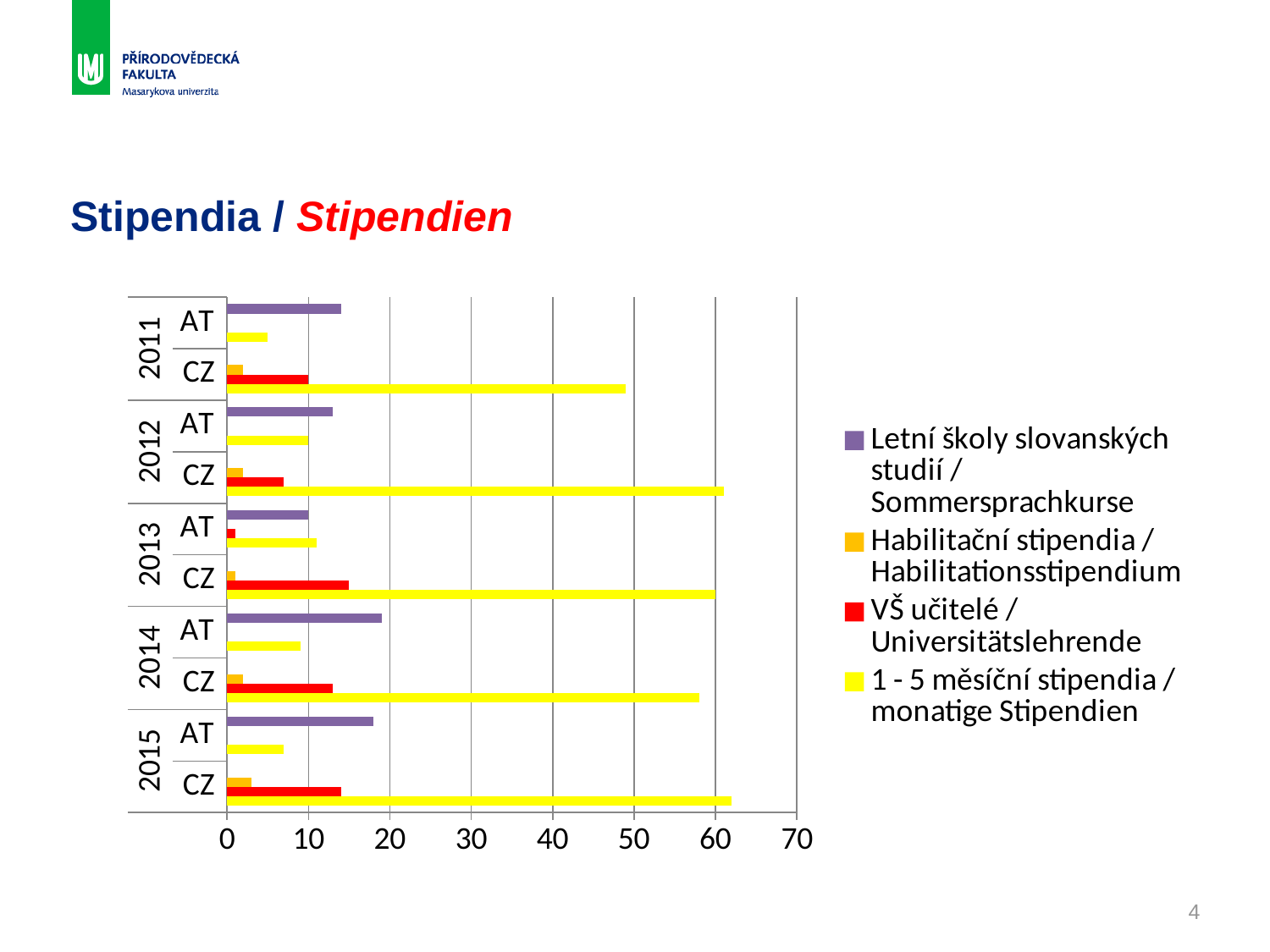
Is the value for '1 - 5 měsíční stipendia / monatige Stipendien' for CZ in 2011 greater or less than 40? greater How many years are shown on the vertical axis of the chart? 5 What kind of chart is shown on the slide? bar chart Is the value for 'VŠ učitelé / Universitätslehrende' for CZ in 2013 greater or less than 10? greater Among the CZ groups, which year has the lowest value for '1 - 5 měsíční stipendia / monatige Stipendien'? 2011 Which is larger: the '1 - 5 měsíční stipendia / monatige Stipendien' value for CZ in 2011 or for CZ in 2015? CZ in 2015 How many category groups (year/country combinations) are shown on the chart? 10 Is the value for 'VŠ učitelé / Universitätslehrende' for CZ in 2012 greater or less than 10? less How many series does the legend list? 4 What is the title of the slide containing the chart? Stipendia / Stipendien